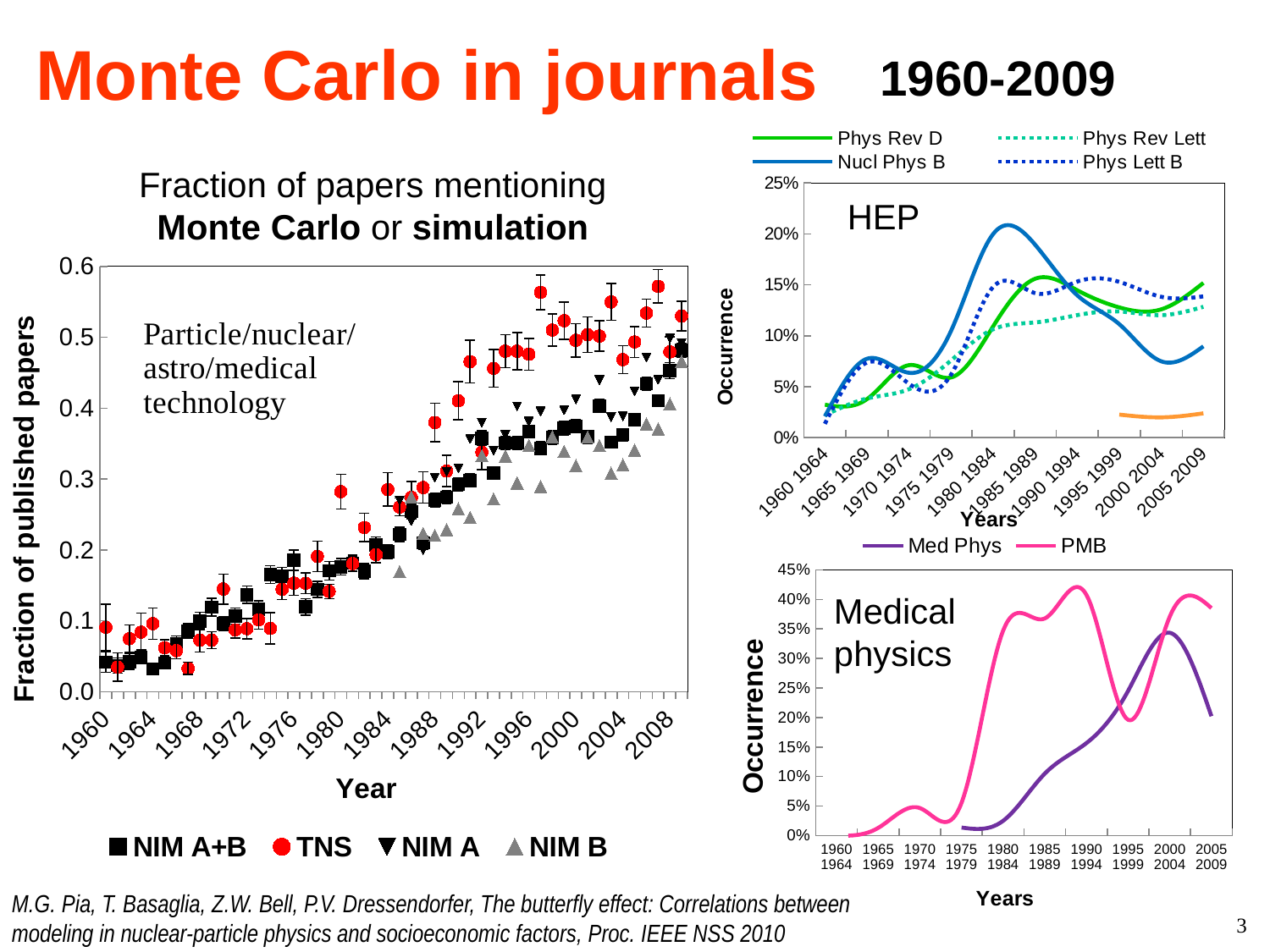
On the HEP chart, how many year-range categories are shown on the x axis? 10 On the left chart, is the value for TNS in 1960 greater or less than 0.2? less What kind of chart is the left chart showing the fraction of published papers by year? Scatter chart On the HEP chart (top right), how many series does the legend list? 4 On the left chart, do the values for TNS generally rise or fall from 1960 to 2008? Rise On the Medical physics chart (bottom right), how many series does the legend list? 2 On the Medical physics chart, what is the label of the y axis? Occurrence On the HEP chart, is the peak value for Nucl Phys B in 1985-1989 greater or less than 15%? greater On the Medical physics chart, which series has the higher value in 2005-2009, Med Phys or PMB? PMB On the left chart (Fraction of papers mentioning Monte Carlo or simulation), how many series does the legend list? 4 On the HEP chart, which series reaches the highest peak occurrence? Nucl Phys B